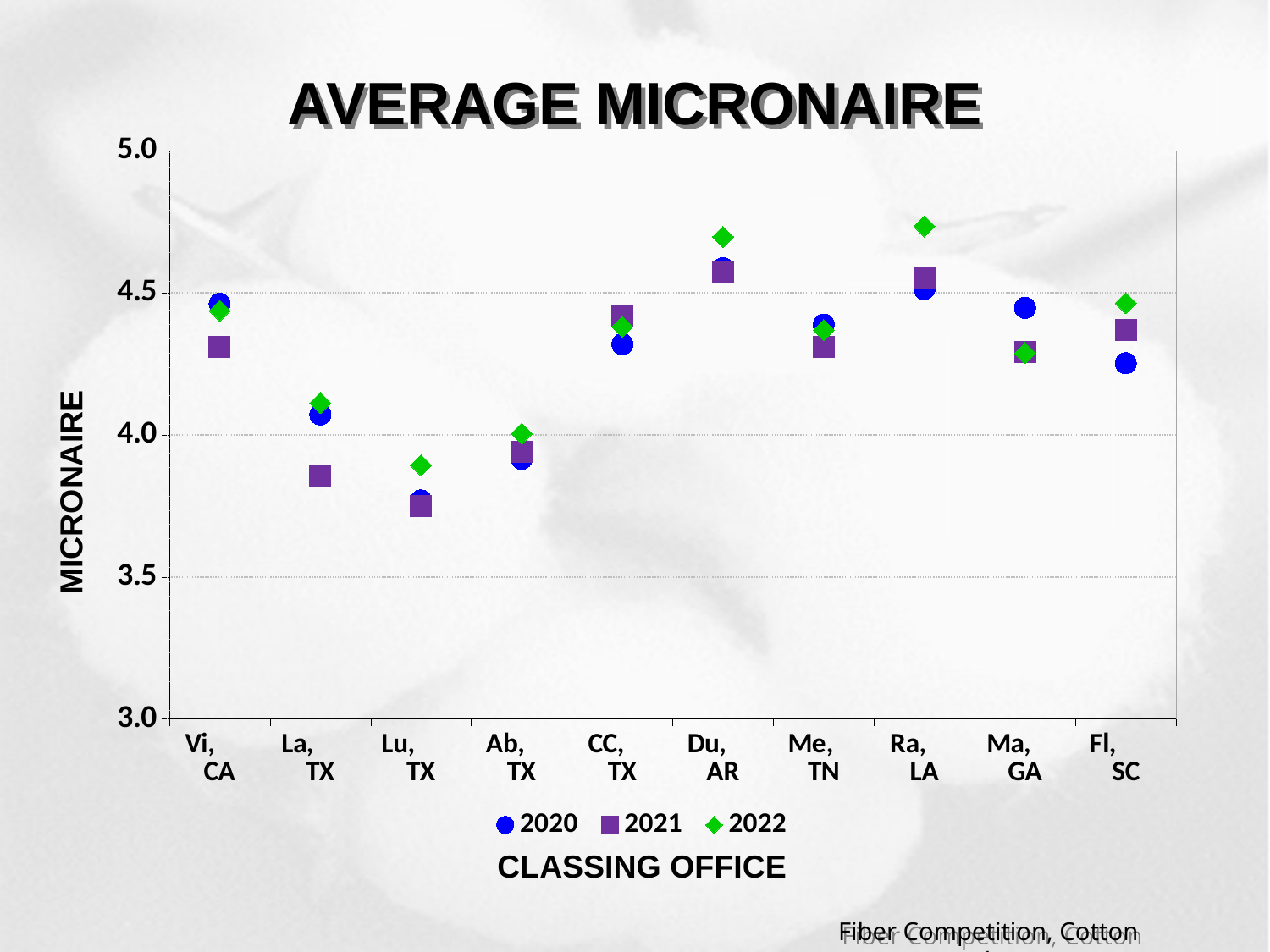
Is the 2021 value for La, TX greater or less than 4.0? less How many classing offices are shown on the x axis? 10 Is the 2022 value for Du, AR greater or less than 4.5? greater For Fl, SC, which is larger: the 2022 value or the 2020 value? 2022 What is the title of the chart? AVERAGE MICRONAIRE Which classing office has the lowest 2022 micronaire? Lu, TX For Vi, CA, which is larger: the 2020 value or the 2021 value? 2020 What is the label of the x axis? CLASSING OFFICE Which classing office has the highest 2020 micronaire? Du, AR Which classing office has the lowest 2021 micronaire? Lu, TX What kind of chart is this? scatter chart How many series does the legend list? 3